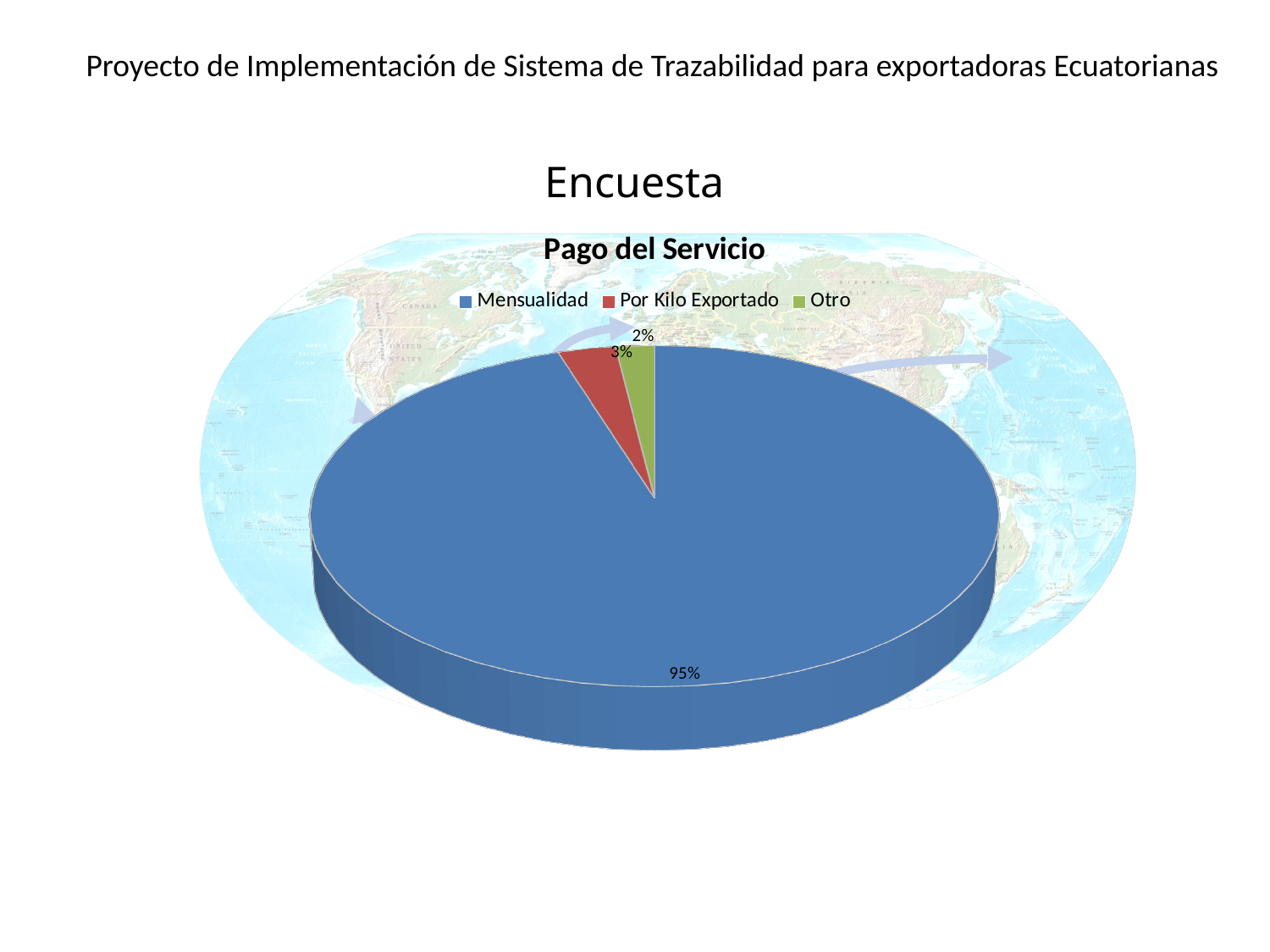
How many entries does the legend list? 3 What kind of chart is shown on the slide? Pie chart Which category has the smallest share of the pie? Otro What is the difference in percentage points between Mensualidad and Por Kilo Exportado? 92 Which is larger, the share for Por Kilo Exportado or the share for Otro? Por Kilo Exportado What colour is the Mensualidad slice? Blue Which category has the largest share of the pie? Mensualidad What percentage of the pie does Mensualidad represent? 95% What percentage of the pie does Otro represent? 2% How many categories does the pie chart show? 3 What percentage of the pie does Por Kilo Exportado represent? 3% What is the title of the chart? Pago del Servicio